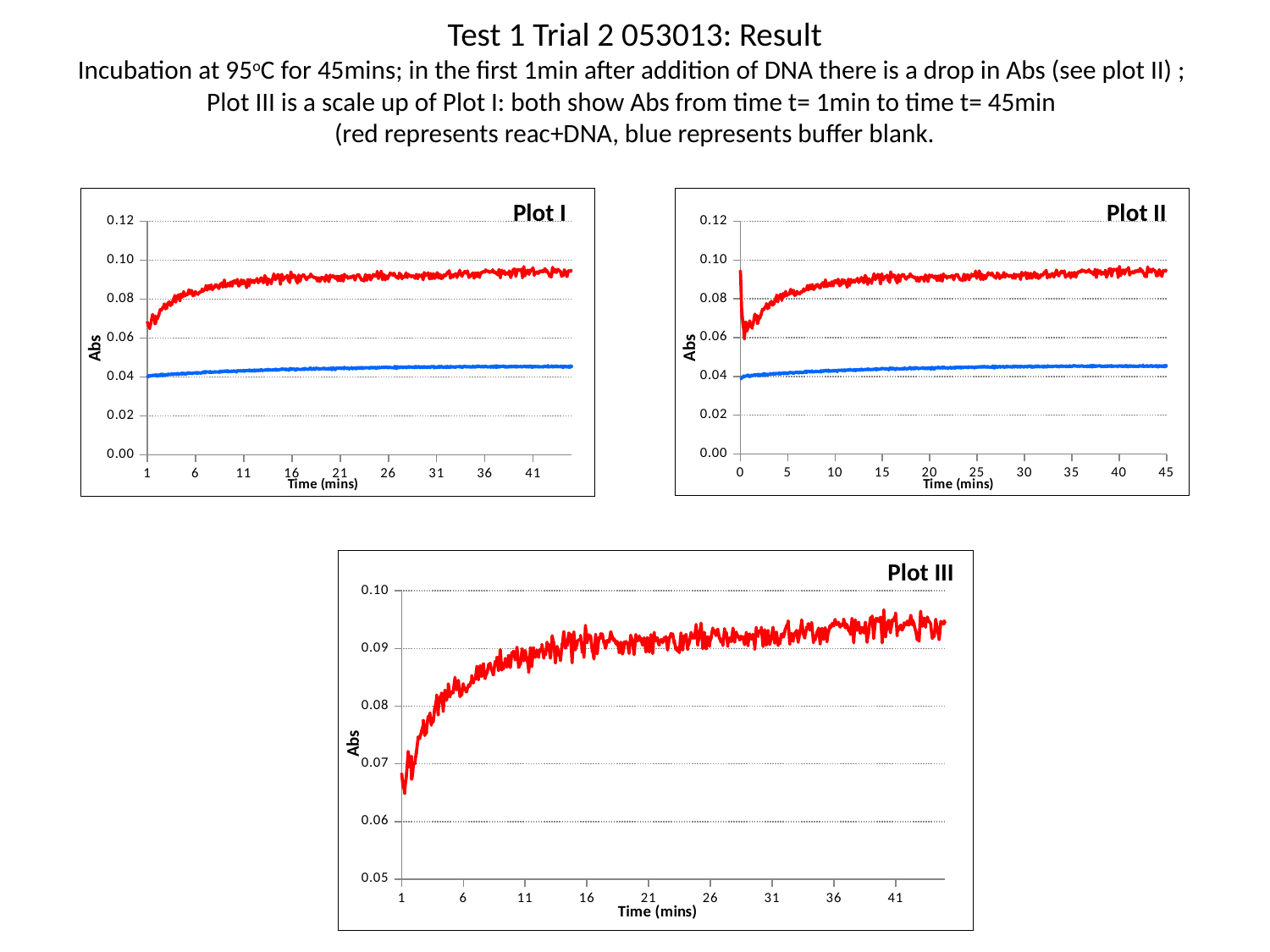
In Plot II, does the red series generally rise or fall between 5 and 45 mins? rise What is the y-axis label of Plot III? Abs In Plot III, is the Abs value at 1 min greater or less than 0.08? less In Plot I, is the Abs value of the blue series at 41 mins greater or less than 0.06? less What kind of chart is Plot I? line chart In Plot I, which series has the higher Abs values throughout, the red or the blue? red In Plot III, does the Abs value generally rise or fall as time increases? rise What is the x-axis label of Plot II? Time (mins) In Plot I, how many data series are plotted? 2 In Plot II, is the Abs value of the blue series at 45 mins greater or less than 0.06? less